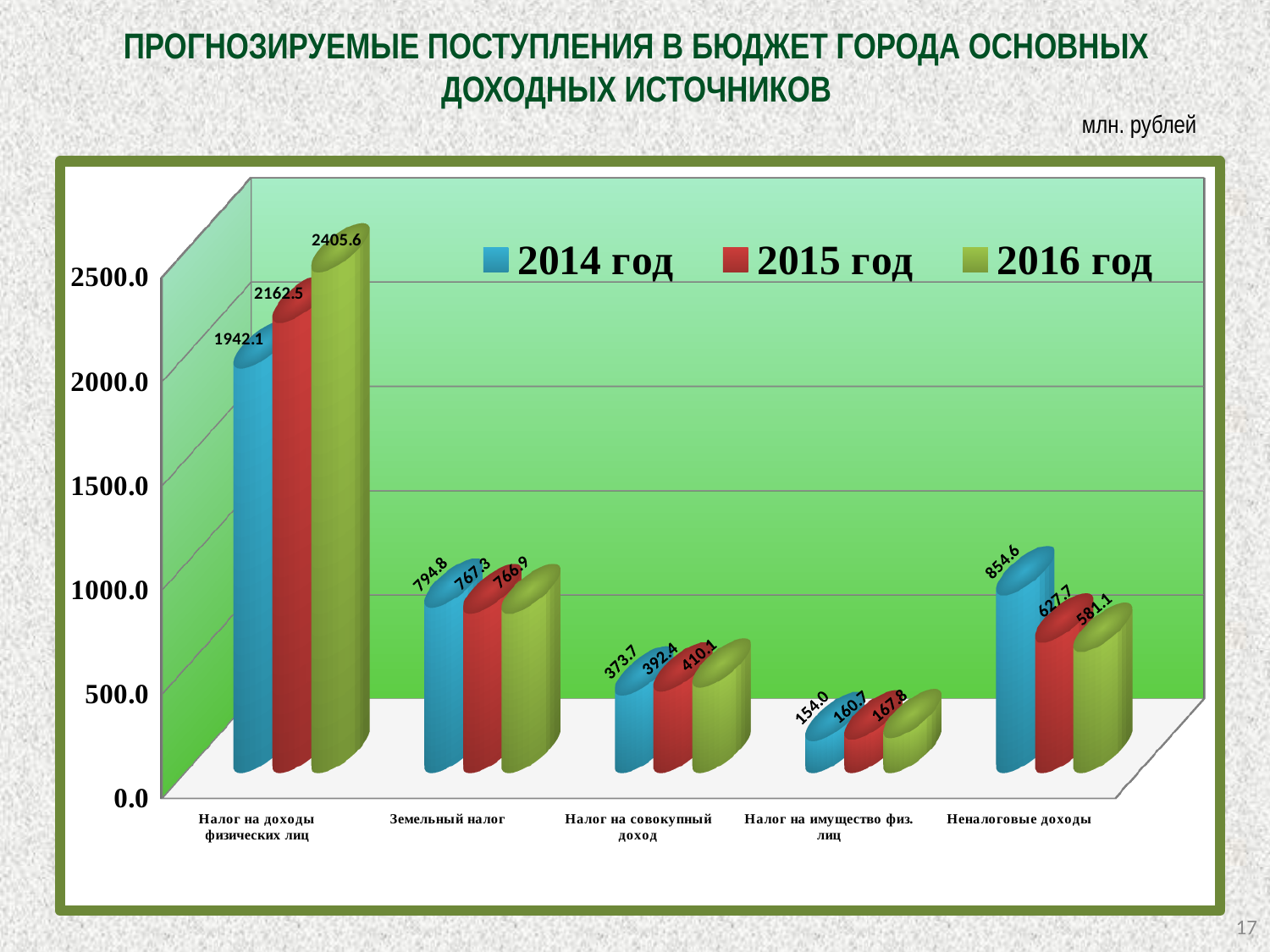
Is the value for Земельный налог in 2014 год greater or less than 1000.0? less Which is larger for Неналоговые доходы: the 2014 год value or the 2015 год value? 2014 год How many series does the legend list? 3 What is the value for Неналоговые доходы in 2016 год? 581.1 What kind of chart is shown on the slide? bar chart What is the value for Налог на совокупный доход in 2015 год? 392.4 What is the value for Налог на доходы физических лиц in 2014 год? 1942.1 Which category has the lowest value in 2014 год? Налог на имущество физ. лиц Do the values for Налог на имущество физ. лиц rise or fall from 2014 год to 2016 год? rise How many categories are shown on the x axis? 5 Which category has the highest value in 2016 год? Налог на доходы физических лиц What is the difference between the 2016 год and 2014 год values for Налог на доходы физических лиц? 463.5